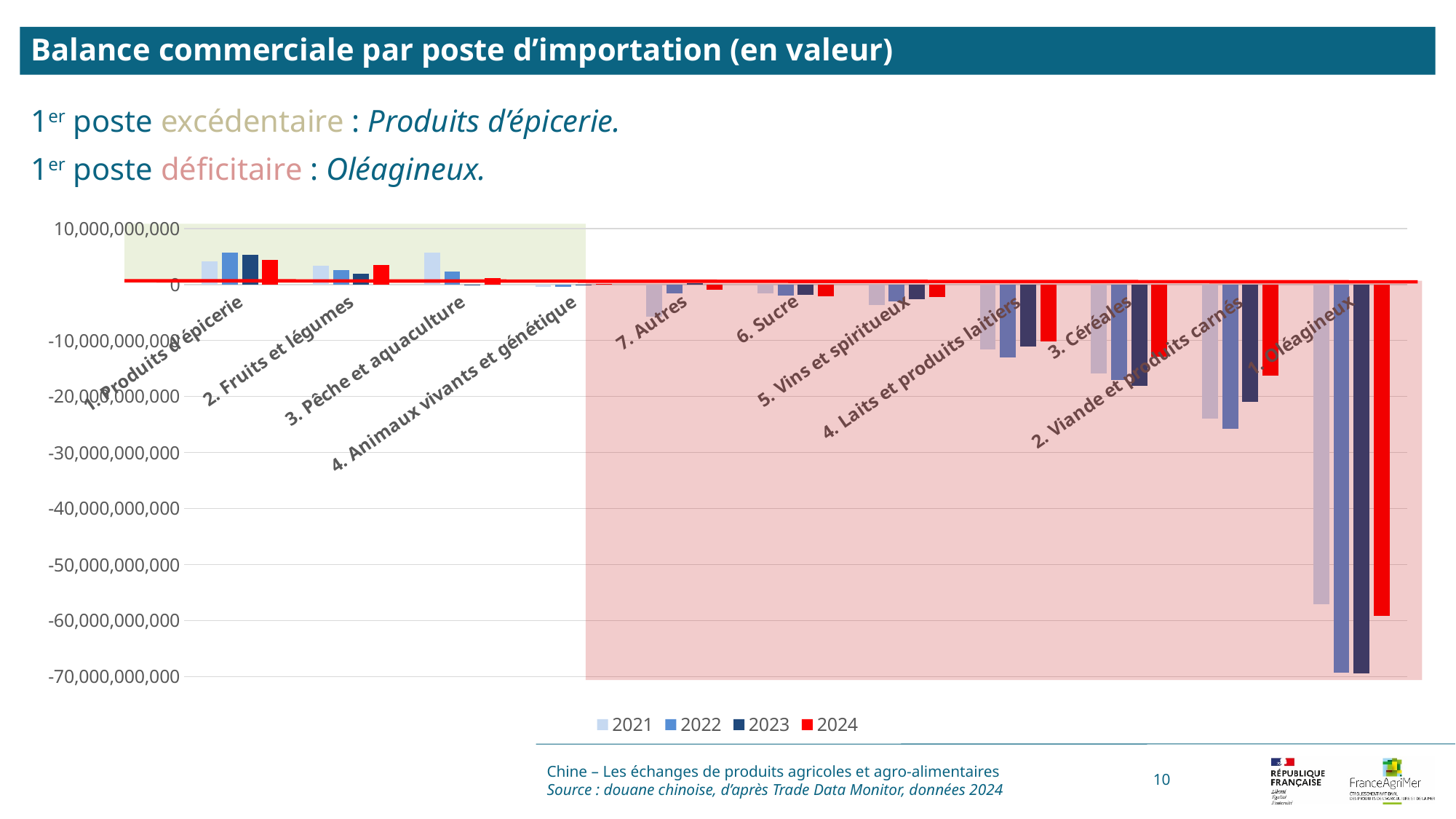
Is the 2024 value for 1. Oléagineux greater or less than -50,000,000,000? less How many series does the chart legend list? 4 Which years are listed in the chart legend? 2021, 2022, 2023, 2024 How many import categories are shown on the x axis of the chart? 11 What kind of chart is shown on the slide? bar chart Is the 2022 value for 2. Viande et produits carnés greater or less than -20,000,000,000? less Which has the higher 2024 value: 2. Viande et produits carnés or 1. Oléagineux? 2. Viande et produits carnés Which category has the lowest (most negative) trade balance in the chart? 1. Oléagineux What is the title of the chart slide? Balance commerciale par poste d'importation (en valeur) Is the 2024 value for 1. Produits d'épicerie greater or less than 0? greater